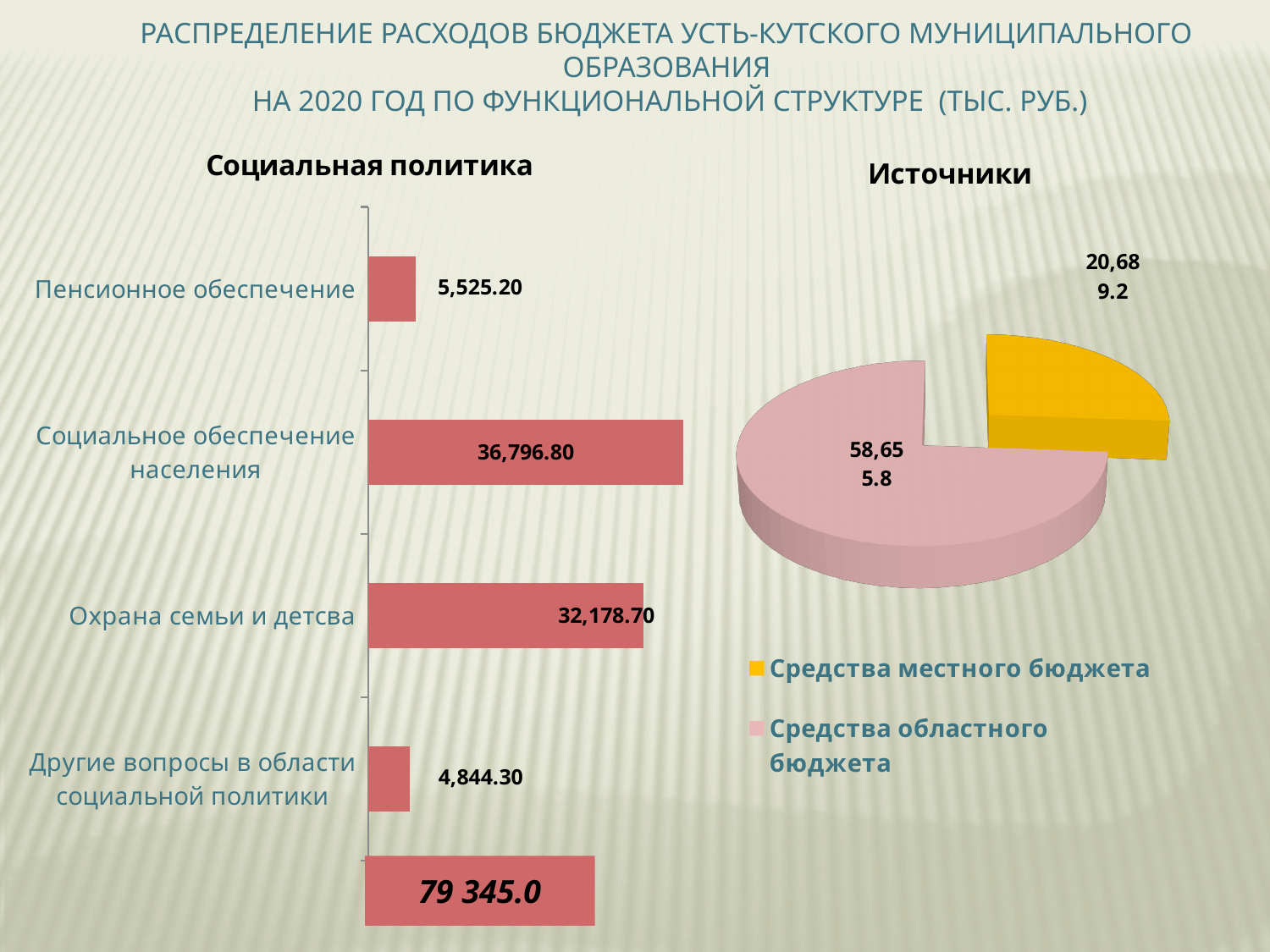
In the 'Источники' chart, which source has the larger share: 'Средства местного бюджета' or 'Средства областного бюджета'? Средства областного бюджета In the 'Социальная политика' chart, what is the value for 'Социальное обеспечение населения'? 36,796.80 What kind of chart is the 'Социальная политика' chart? bar chart In the 'Социальная политика' chart, what is the difference between 'Социальное обеспечение населения' and 'Охрана семьи и детсва'? 4,618.10 In the 'Социальная политика' chart, what is the value for 'Другие вопросы в области социальной политики'? 4,844.30 How many entries does the legend of the 'Источники' chart list? 2 In the 'Социальная политика' chart, what is the value for 'Пенсионное обеспечение'? 5,525.20 In the 'Социальная политика' chart, which is larger: 'Пенсионное обеспечение' or 'Другие вопросы в области социальной политики'? Пенсионное обеспечение In the 'Социальная политика' chart, which category has the lowest value? Другие вопросы в области социальной политики How many categories are shown in the 'Социальная политика' chart? 4 In the 'Социальная политика' chart, which category has the highest value? Социальное обеспечение населения In the 'Социальная политика' chart, what is the value for 'Охрана семьи и детсва'? 32,178.70